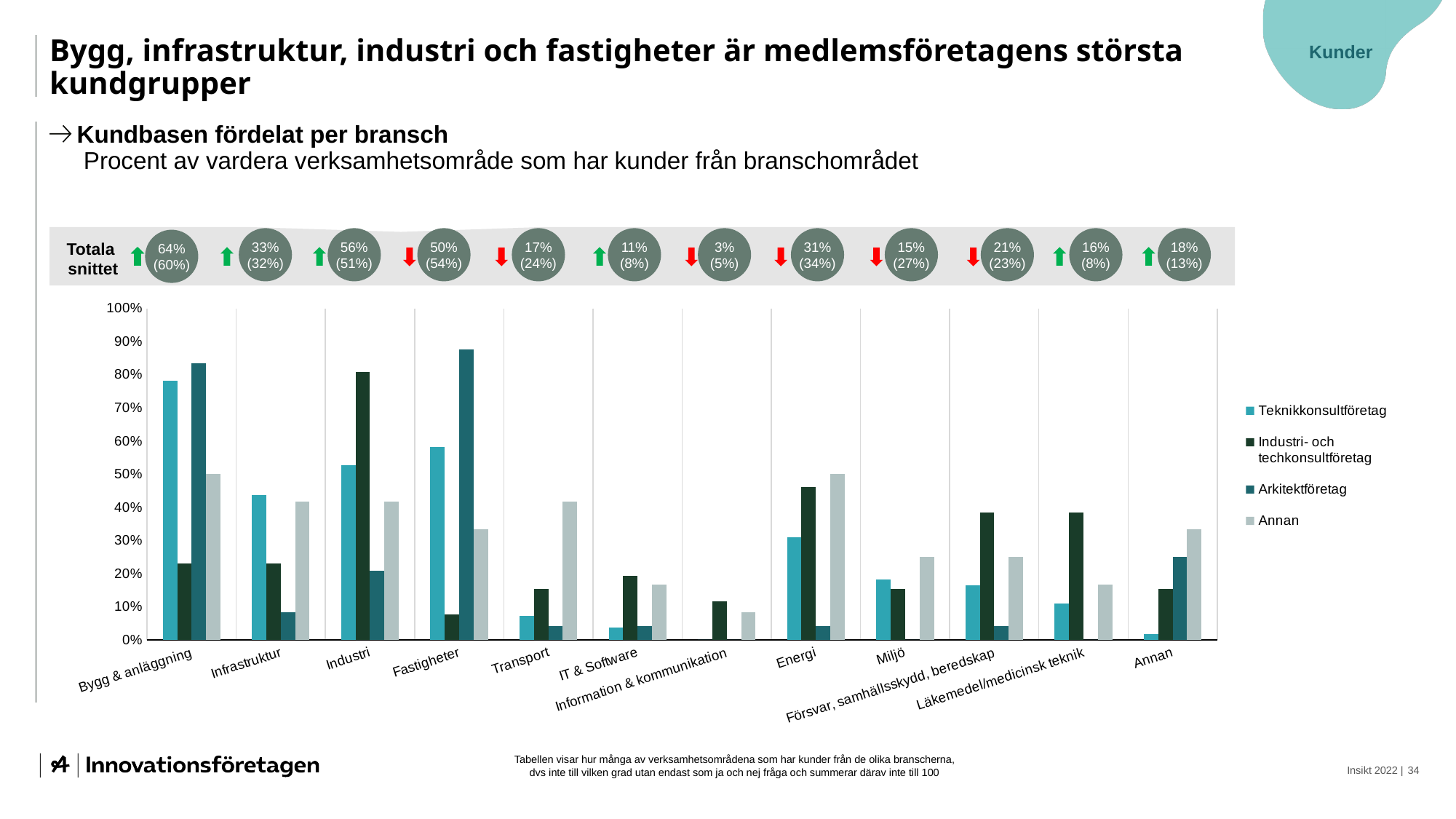
Which category has the highest value for Teknikkonsultföretag? Bygg & anläggning Which category has the highest value for Arkitektföretag? Fastigheter Is the value for Annan in Transport greater or less than 30%? greater How many series does the legend list? 4 Is the value for Arkitektföretag in Fastigheter greater or less than 80%? greater What kind of chart is shown on the slide? bar chart Which category has the highest value for Industri- och techkonsultföretag? Industri Is the value for Teknikkonsultföretag in Bygg & anläggning greater or less than 70%? greater How many categories are shown on the x axis? 12 Which is larger, the Teknikkonsultföretag value for Bygg & anläggning or for Infrastruktur? Bygg & anläggning What is the 'Totala snittet' value shown above the Industri category? 56% (51%)